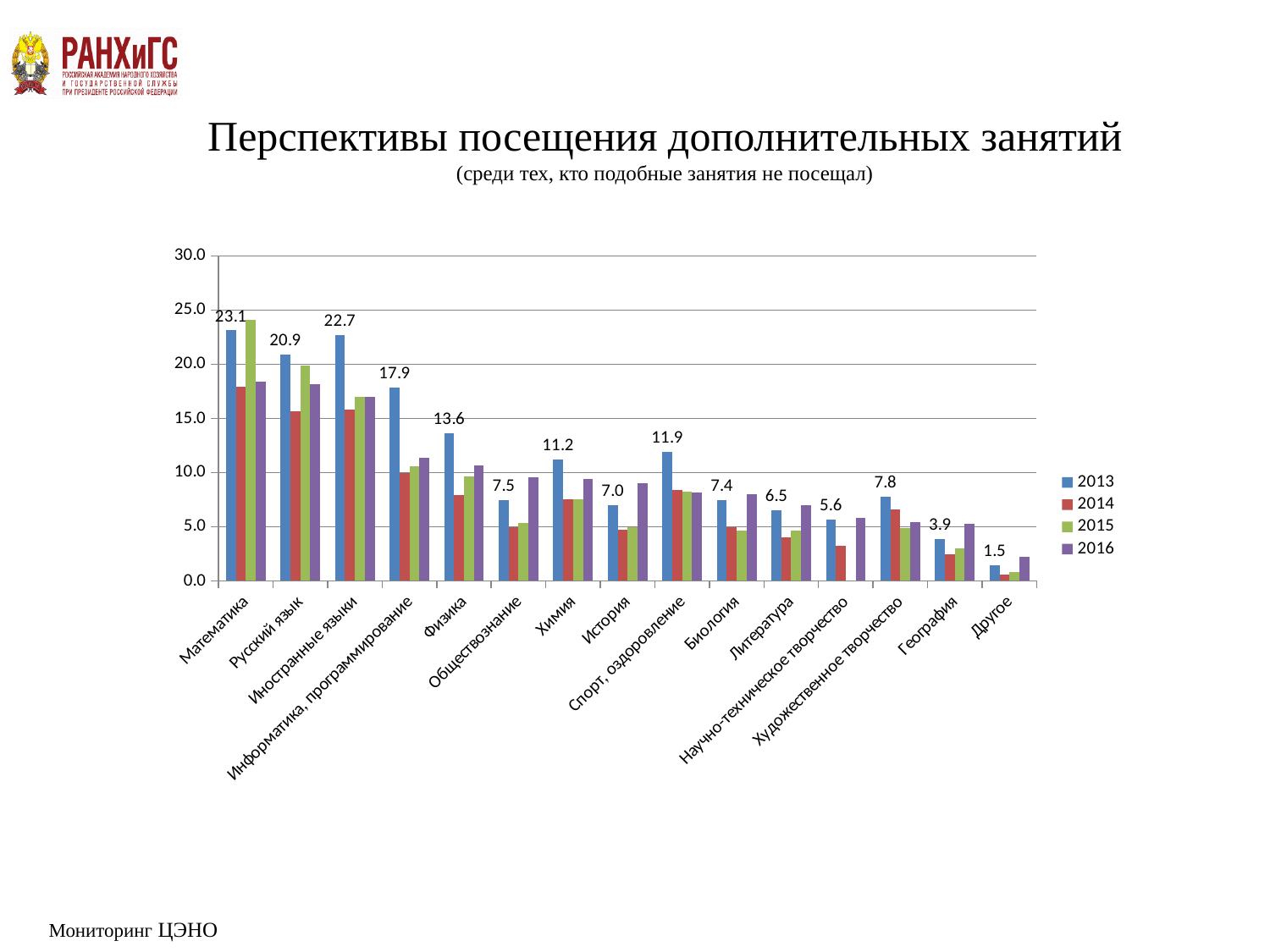
Is the 2015 value for Математика greater or less than 20.0? greater What is the 2013 value for Математика? 23.1 How many categories are shown on the x axis? 15 What is the 2013 value for Иностранные языки? 22.7 Which category has the highest 2013 value? Математика Which has the larger 2013 value, Физика or Химия? Физика How many series does the legend list? 4 What is the difference between the 2013 values for Математика and Русский язык? 2.2 What is the 2013 value for Спорт, оздоровление? 11.9 What is the 2013 value for География? 3.9 Which category has the lowest 2013 value? Другое What kind of chart is shown on the slide? Bar chart